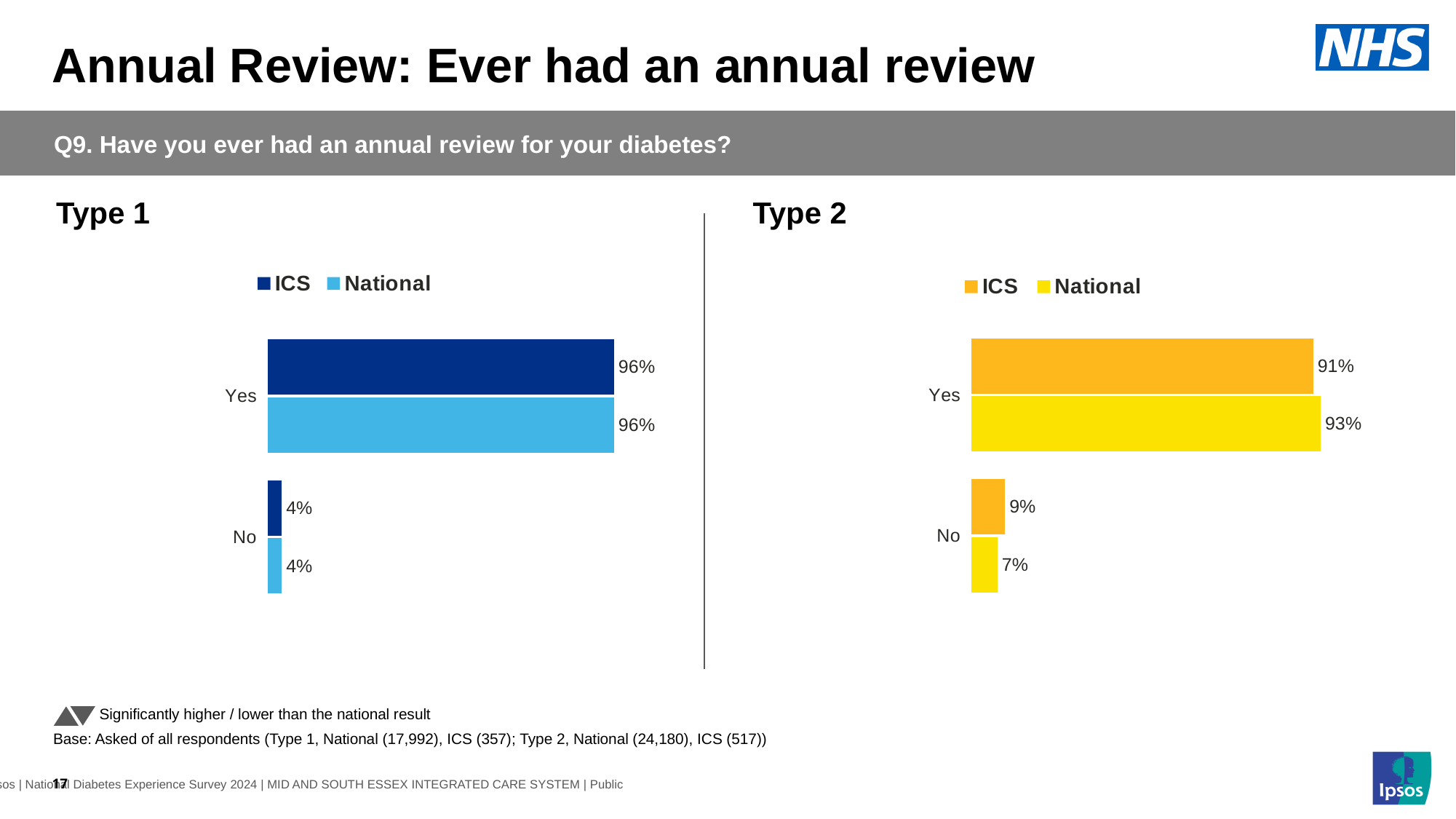
In the Type 2 chart, what is the ICS value for No? 9% In the Type 2 chart, what colour are the National bars? Yellow How many categories are shown in the Type 2 chart? 2 In the Type 2 chart, what is the difference between the National and ICS values for Yes? 2% In the Type 2 chart, what is the National value for Yes? 93% In the Type 2 chart, which is larger for No: ICS or National? ICS In the Type 1 chart, what is the ICS value for Yes? 96% What kind of chart is the Type 1 chart? Bar chart In the Type 2 chart, what is the ICS value for Yes? 91% In the Type 1 chart, how many series does the legend list? 2 In the Type 1 chart, what is the National value for No? 4% In the Type 2 chart, which series has the higher value for Yes? National